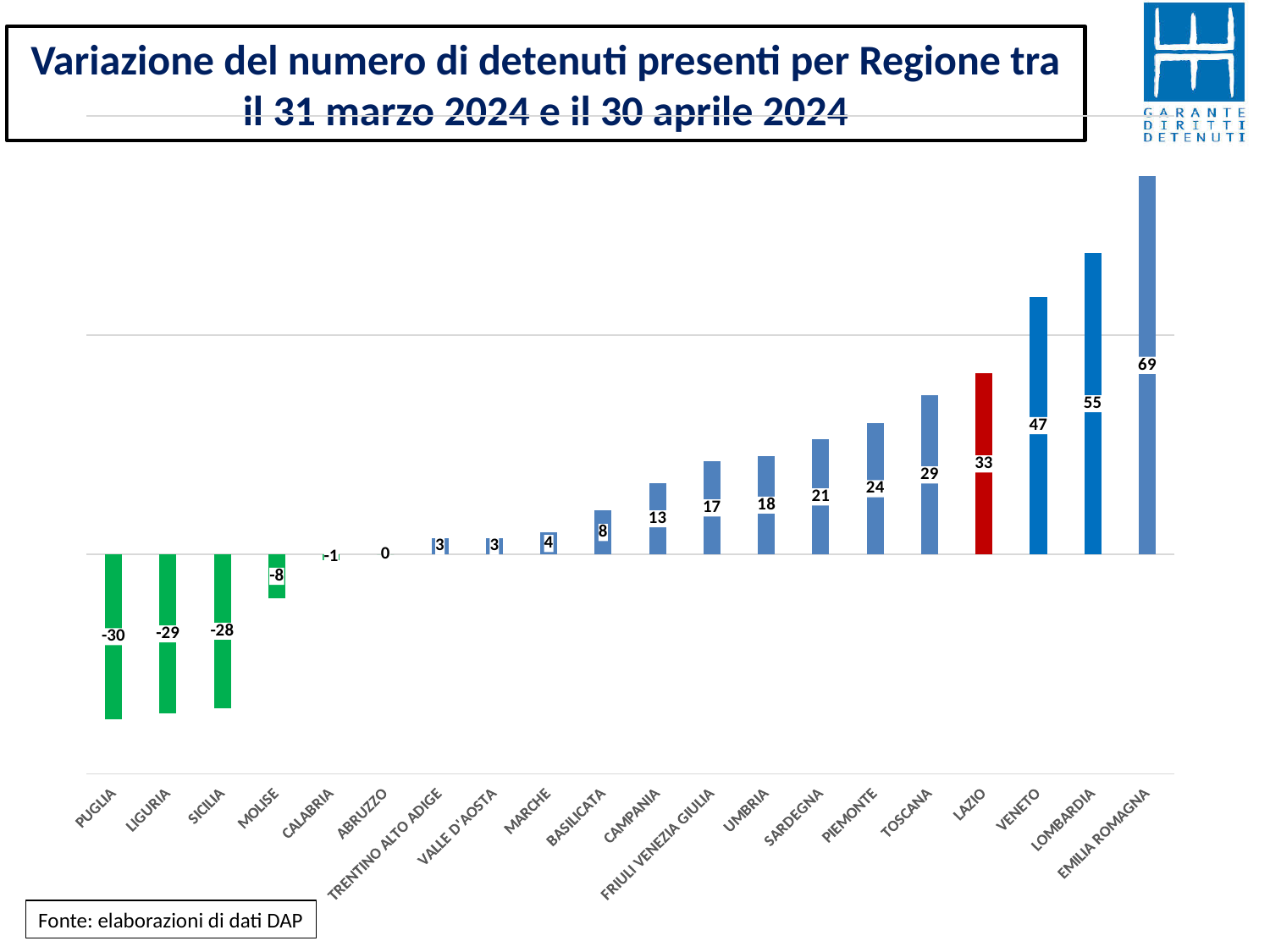
Which region has the lowest value? Puglia What is the difference between the values for Veneto and Lazio? 14 Which is larger, the value for Piemonte or the value for Sardegna? Piemonte What is the value for Lazio? 33 What is the value for Abruzzo? 0 What is the difference between the values for Emilia Romagna and Lombardia? 14 What is the value for Puglia? -30 How many regions are shown on the chart? 20 Which region has the highest value? Emilia Romagna What is the value for Molise? -8 Do the values rise or fall from left to right along the x axis? Rise What kind of chart is shown on the slide? Bar chart